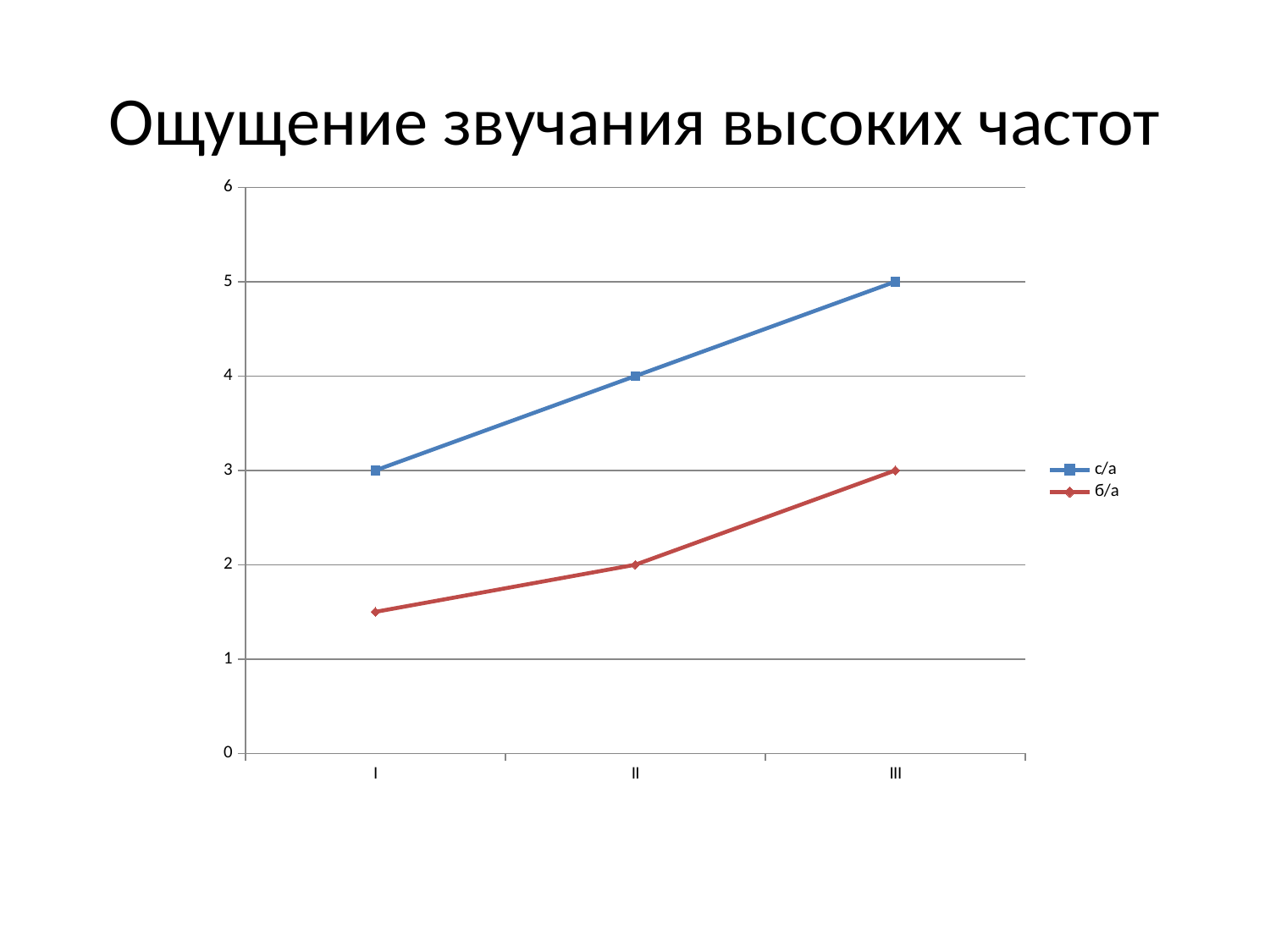
What is the title of the slide? Ощущение звучания высоких частот How many categories are on the x axis? 3 What is the value of the б/а series at category II? 2 Do the values of the с/а series rise or fall from category I to category III? rise Is the value of the б/а series at category I greater or less than 2? less What is the value of the с/а series at category III? 5 How many series does the legend list? 2 What is the difference between the с/а and б/а values at category III? 2 What is the value of the с/а series at category I? 3 What is the value of the б/а series at category III? 3 At category II, which series has the higher value, с/а or б/а? с/а What kind of chart is shown on the slide? line chart